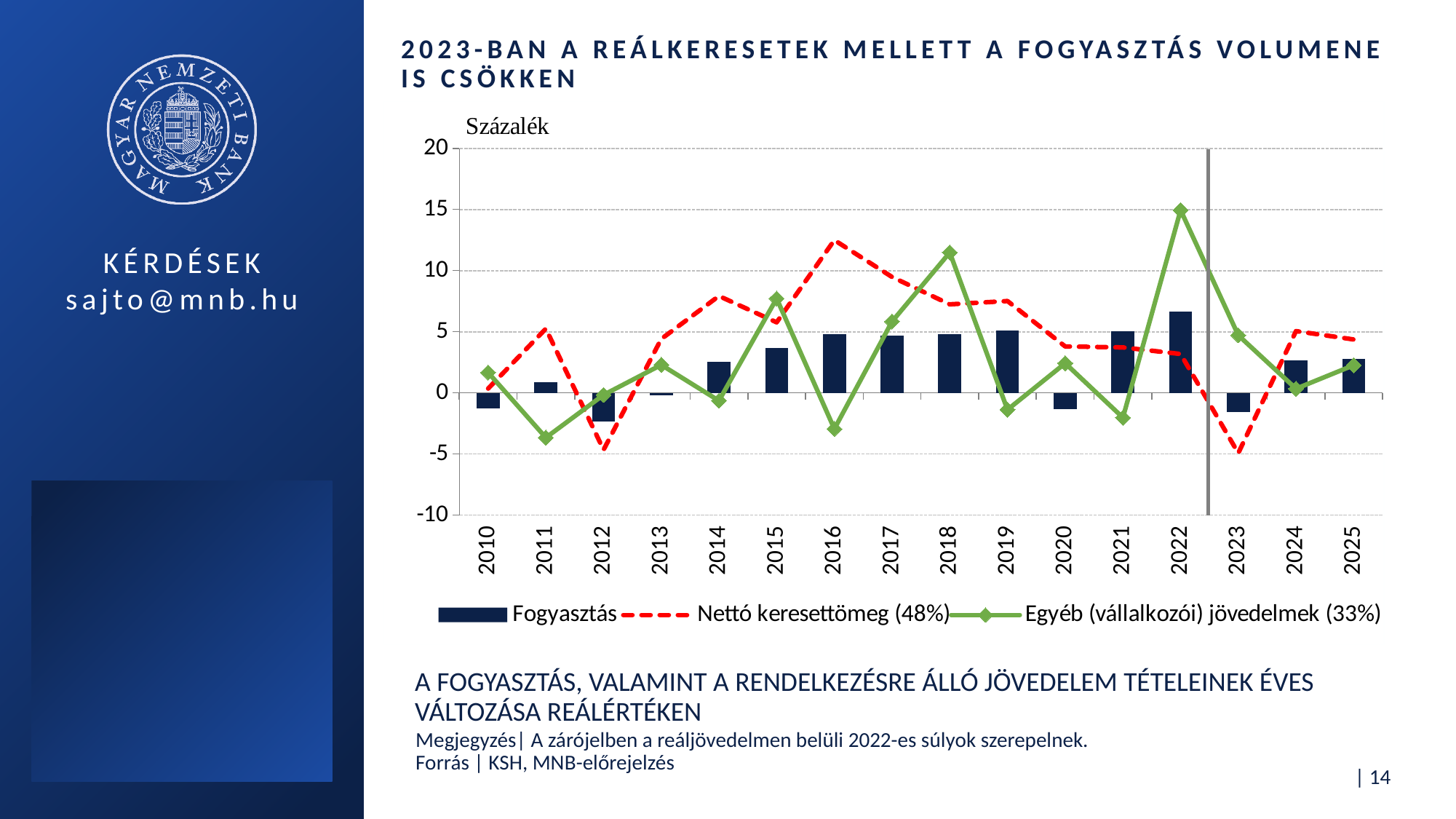
Is the value of Egyéb (vállalkozói) jövedelmek in 2022 greater or less than 10? greater In which year does the Egyéb (vállalkozói) jövedelmek line reach its highest value? 2022 In which year does the Nettó keresettömeg line reach its highest value? 2016 Is the Nettó keresettömeg value in 2023 greater or less than 0? less In which year is the Fogyasztás bar the highest? 2022 What unit label is shown above the y axis? Százalék What kind of chart is shown on the slide? Combined bar and line chart Which is larger in 2022: the Fogyasztás bar or the Egyéb (vállalkozói) jövedelmek line? Egyéb (vállalkozói) jövedelmek Is the Fogyasztás value in 2012 greater or less than 0? less How many years are shown on the x axis? 16 Does the Egyéb (vállalkozói) jövedelmek line rise or fall from 2022 to 2024? Fall How many series does the legend list? 3